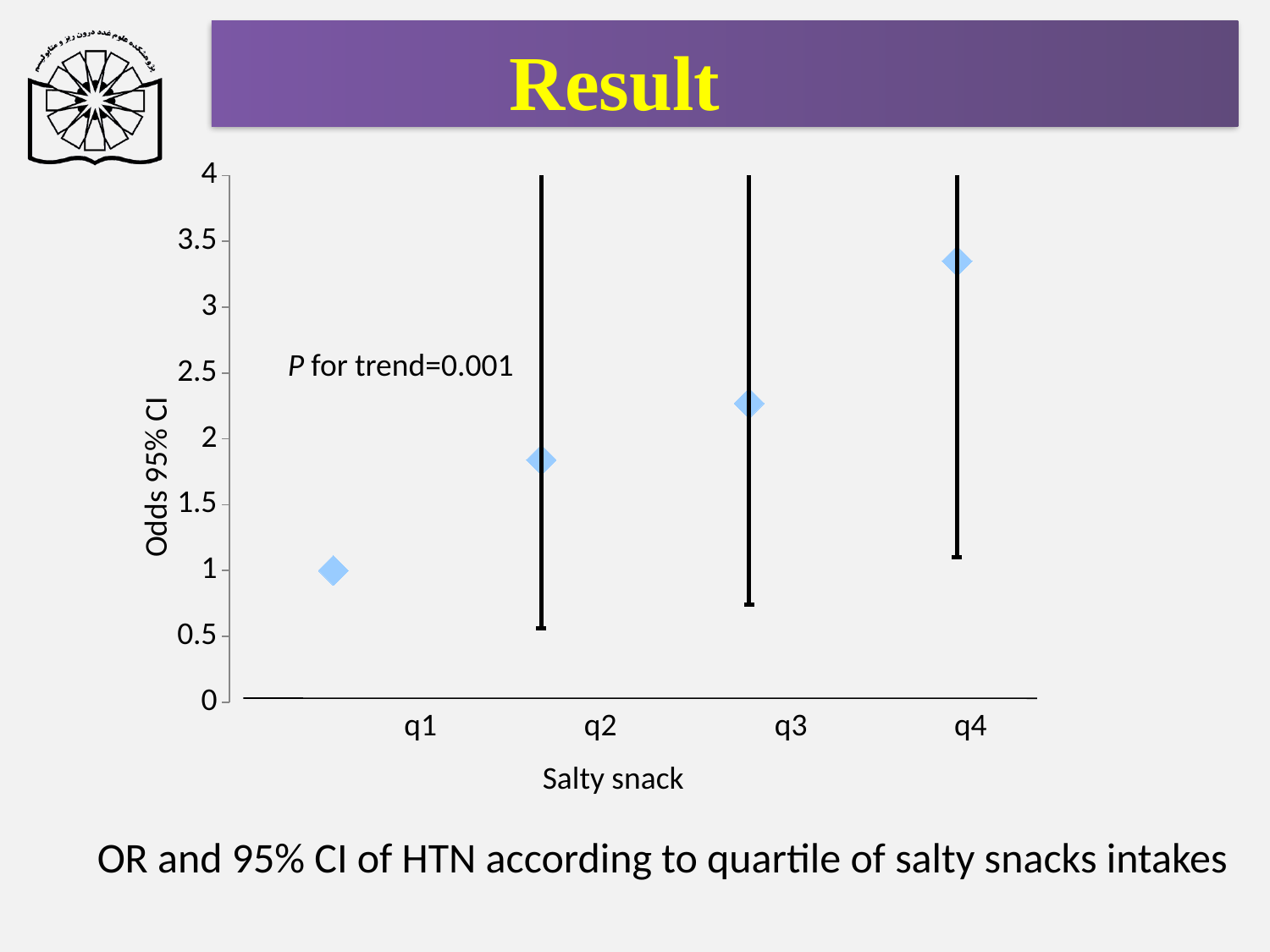
How many quartile categories are plotted on the x axis? 4 Which has a larger plotted odds value, q2 or q4? q4 Which quartile has the highest plotted odds value? q4 What P for trend value is annotated on the chart? P for trend=0.001 What kind of chart is shown on the slide? scatter chart Do the plotted odds values rise or fall from q1 to q4? rise Is the plotted odds value for q4 greater or less than 3? greater What is the label of the x axis? Salty snack Is the plotted odds value for q3 greater or less than 2? greater Which quartile has the lowest plotted odds value? q1 What is the odds value plotted for q1? 1 Is the plotted odds value for q2 greater or less than 2? less